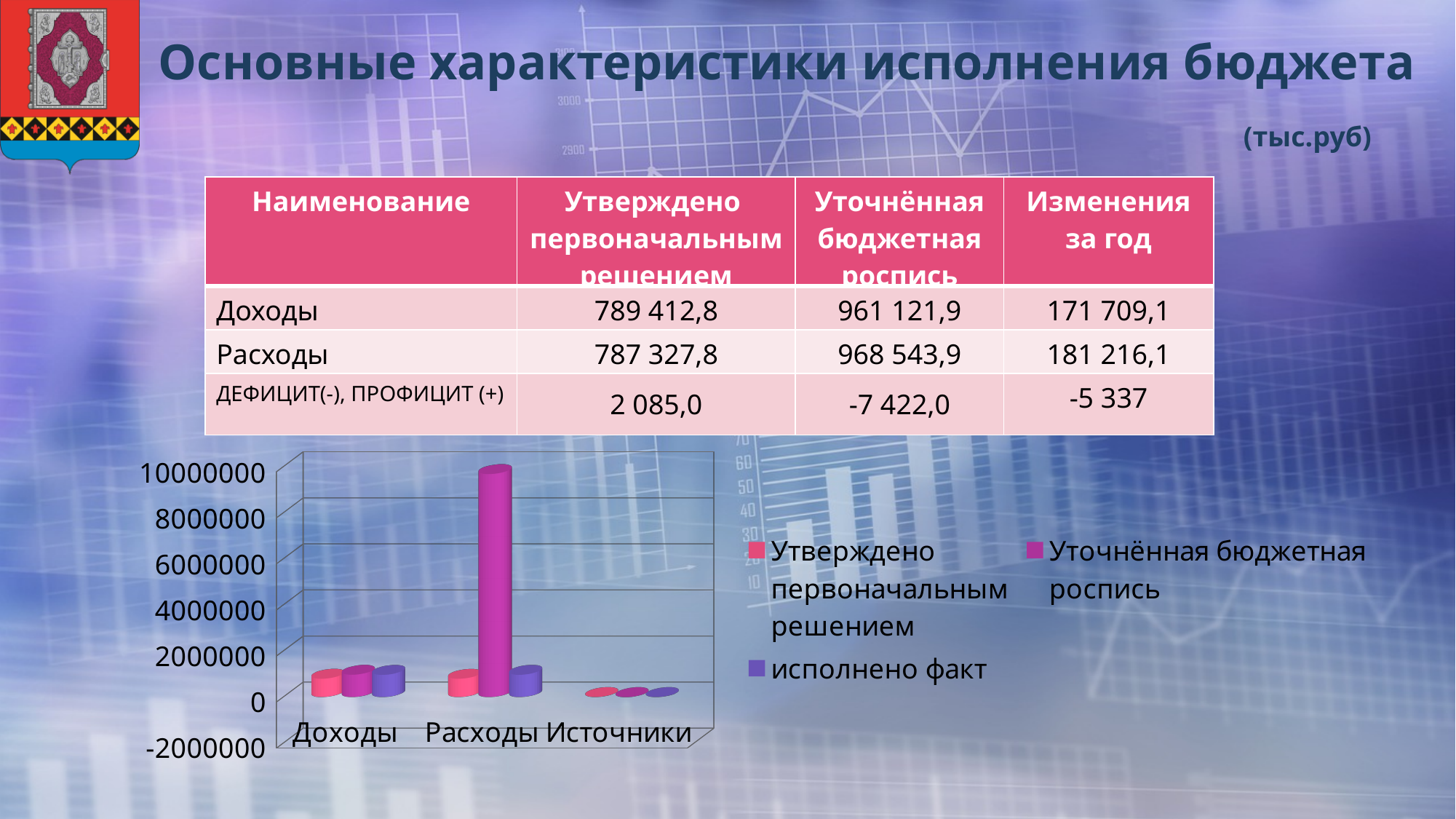
Which series in the bar chart is shown in blue-purple according to the legend? исполнено факт In the bar chart, is the value of Утверждено первоначальным решением for Доходы greater or less than 2000000? less In the bar chart, is the value of исполнено факт for Расходы greater or less than 4000000? less In the bar chart, which is larger: Уточнённая бюджетная роспись for Расходы or Уточнённая бюджетная роспись for Доходы? Расходы How many categories are shown on the x axis of the bar chart? 3 In the bar chart, which category has the smallest bars overall? Источники What is the highest value shown on the y axis of the bar chart? 10000000 In the bar chart, which series has the tallest bar for Расходы? Уточнённая бюджетная роспись In the bar chart, is the value of Уточнённая бюджетная роспись for Расходы greater or less than 8000000? greater In the bar chart, which category has the tallest bar? Расходы How many series does the legend of the bar chart list? 3 What kind of chart is shown at the bottom of the slide? bar chart